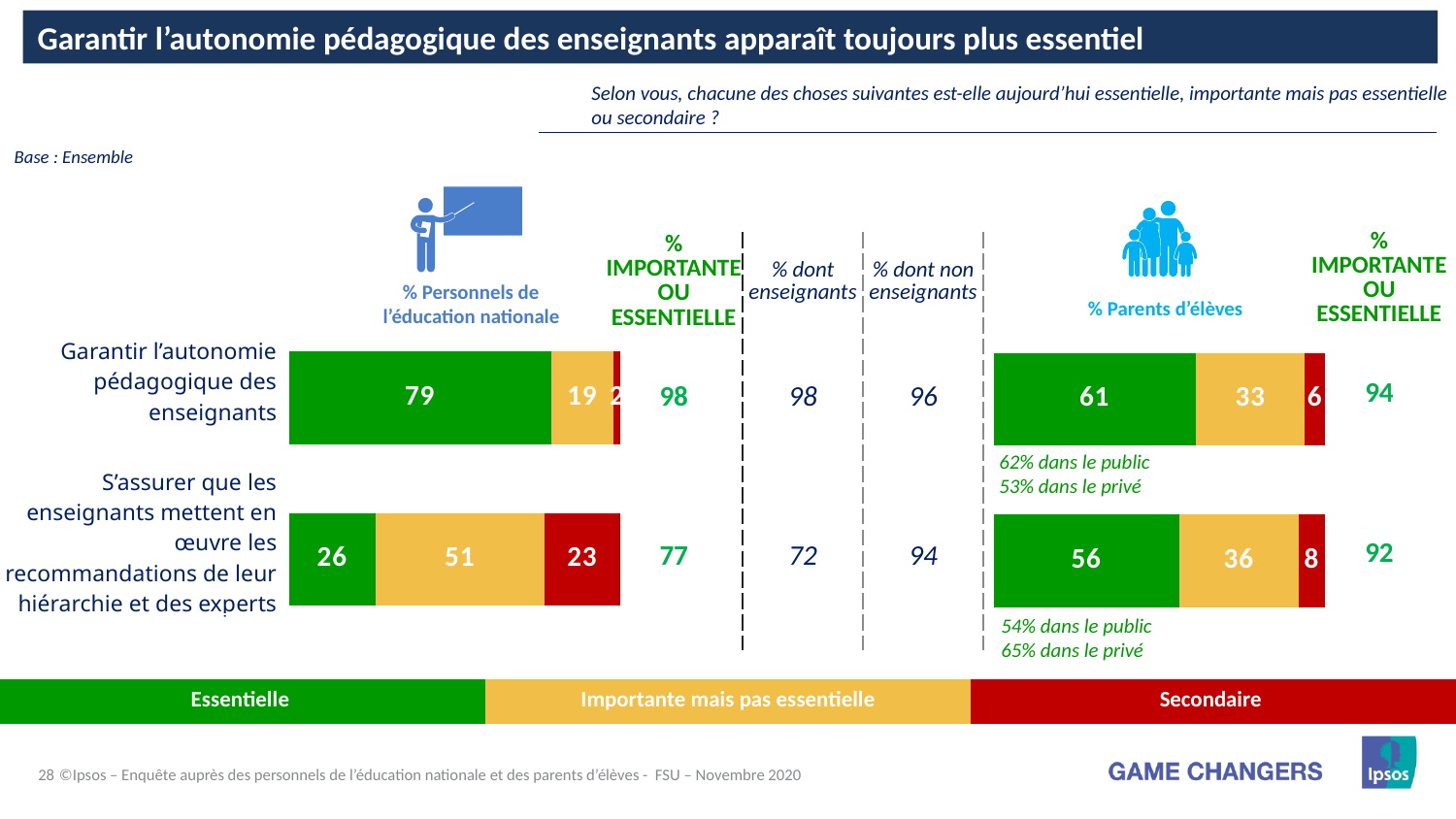
Is the Essentielle value for 'Garantir l'autonomie pédagogique des enseignants' larger in the '% Personnels de l'éducation nationale' chart or in the '% Parents d'élèves' chart? % Personnels de l'éducation nationale How many series does the legend at the bottom of the slide list? 3 In the '% Parents d'élèves' chart, what is the 'Importante mais pas essentielle' value for 'Garantir l'autonomie pédagogique des enseignants'? 33 How many items (categories) are shown in the '% Personnels de l'éducation nationale' chart? 2 In the '% Personnels de l'éducation nationale' chart, what percentage rate 'Garantir l'autonomie pédagogique des enseignants' as Essentielle? 79 In the '% Personnels de l'éducation nationale' chart, which item has the higher Essentielle value? Garantir l'autonomie pédagogique des enseignants In the '% Personnels de l'éducation nationale' chart, what is the difference between the Essentielle values of the two items? 53 In the '% Personnels de l'éducation nationale' chart, what is the 'Importante mais pas essentielle' value for 'S'assurer que les enseignants mettent en œuvre les recommandations de leur hiérarchie et des experts'? 51 In the '% Parents d'élèves' chart, what percentage rate 'S'assurer que les enseignants mettent en œuvre les recommandations de leur hiérarchie et des experts' as Secondaire? 8 In the '% Parents d'élèves' chart, what is the difference between the Secondaire values of the two items? 2 In the '% Parents d'élèves' chart, which item has the lower Essentielle value? S'assurer que les enseignants mettent en œuvre les recommandations de leur hiérarchie et des experts What kind of chart is used to show the '% Parents d'élèves' results? Stacked bar chart